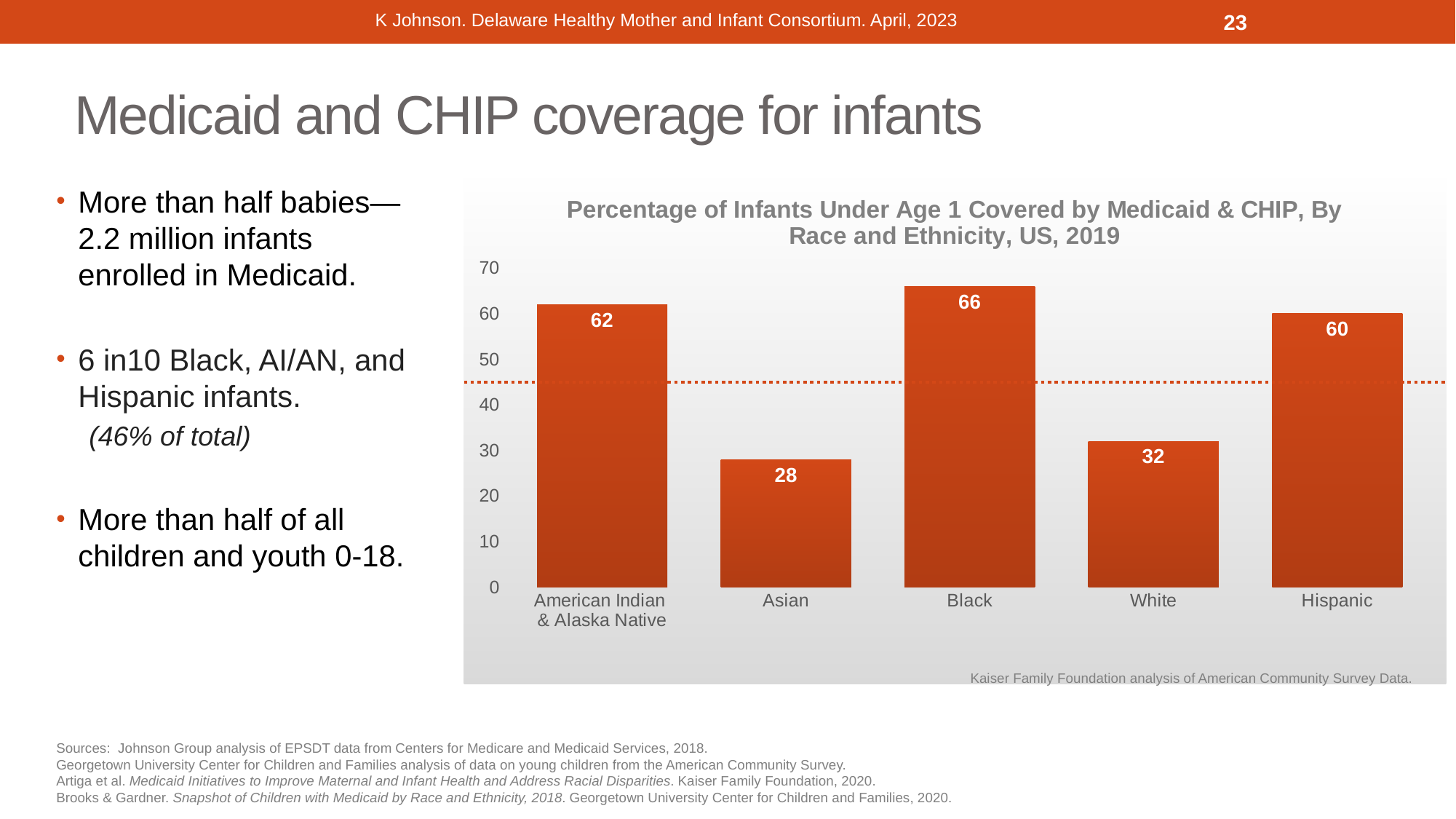
Which is larger, the value for American Indian & Alaska Native infants or the value for Hispanic infants? American Indian & Alaska Native Is the value for White infants greater or less than 40? less What kind of chart is shown on the slide? bar chart What is the difference between the values for Black and White infants? 34 Which race/ethnicity group has the highest percentage of infants covered by Medicaid & CHIP? Black Which race/ethnicity group has the lowest percentage of infants covered by Medicaid & CHIP? Asian What is the value for Hispanic infants in the chart? 60 What is the title of the chart? Percentage of Infants Under Age 1 Covered by Medicaid & CHIP, By Race and Ethnicity, US, 2019 What is the value for Asian infants in the chart? 28 What is the value for Black infants in the chart? 66 How many race/ethnicity categories are shown in the chart? 5 What is the value for White infants in the chart? 32